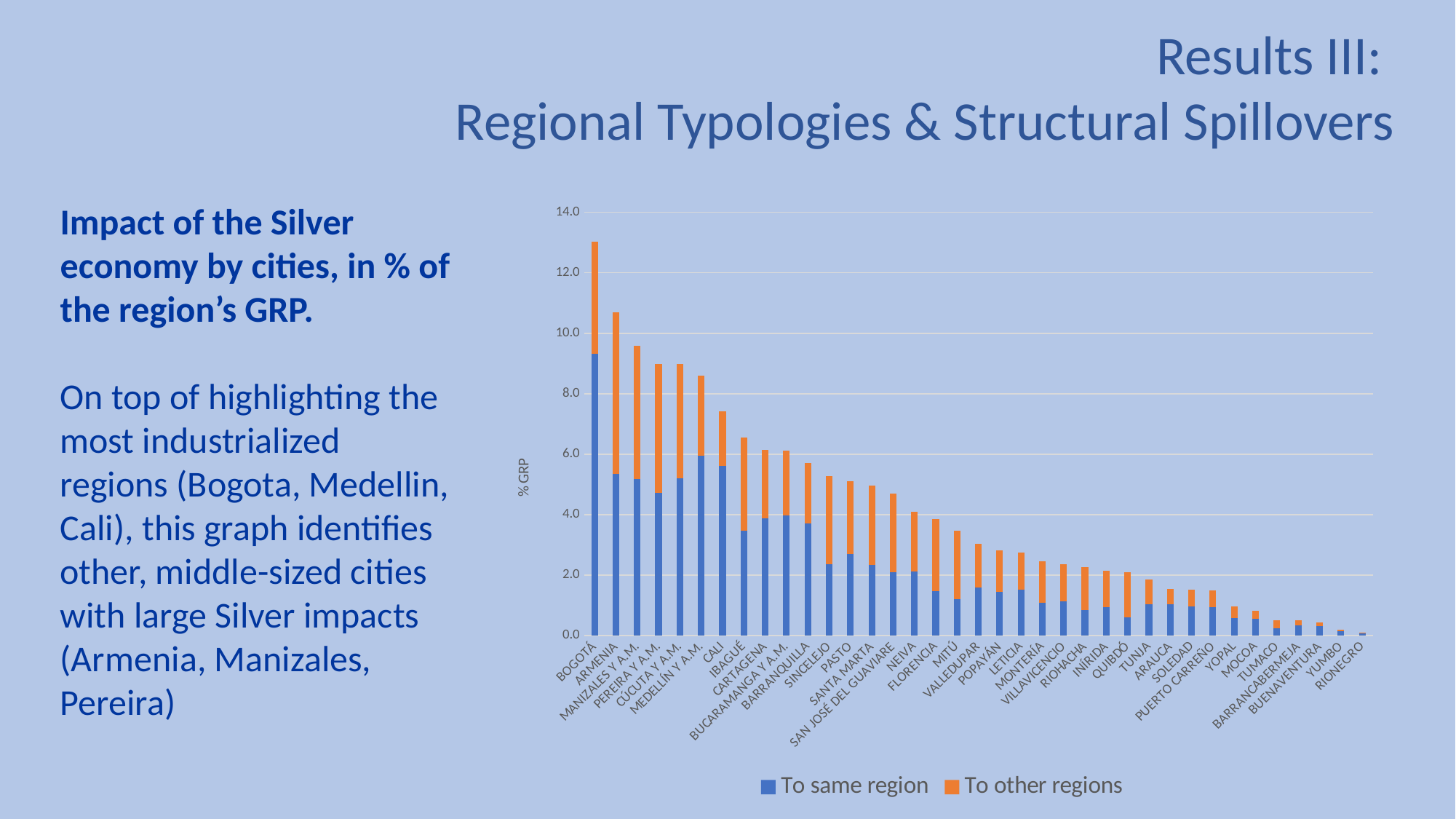
What are the two series named in the legend? To same region; To other regions Which city has the highest total bar? BOGOTÁ How many series does the legend list? 2 Is the total value for ARMENIA greater or less than 10.0? greater Which city has the lowest total bar? RIONEGRO Which city has the larger total bar, MEDELLÍN Y A.M. or IBAGUÉ? MEDELLÍN Y A.M. Is the total value for CALI greater or less than 8.0? less What is the label on the vertical axis? % GRP How many cities are shown on the x axis? 37 What kind of chart is shown on the slide? Stacked bar chart Is the total value for BOGOTÁ greater or less than 12.0? greater Do the total bar heights rise or fall moving from left to right along the x axis? Fall